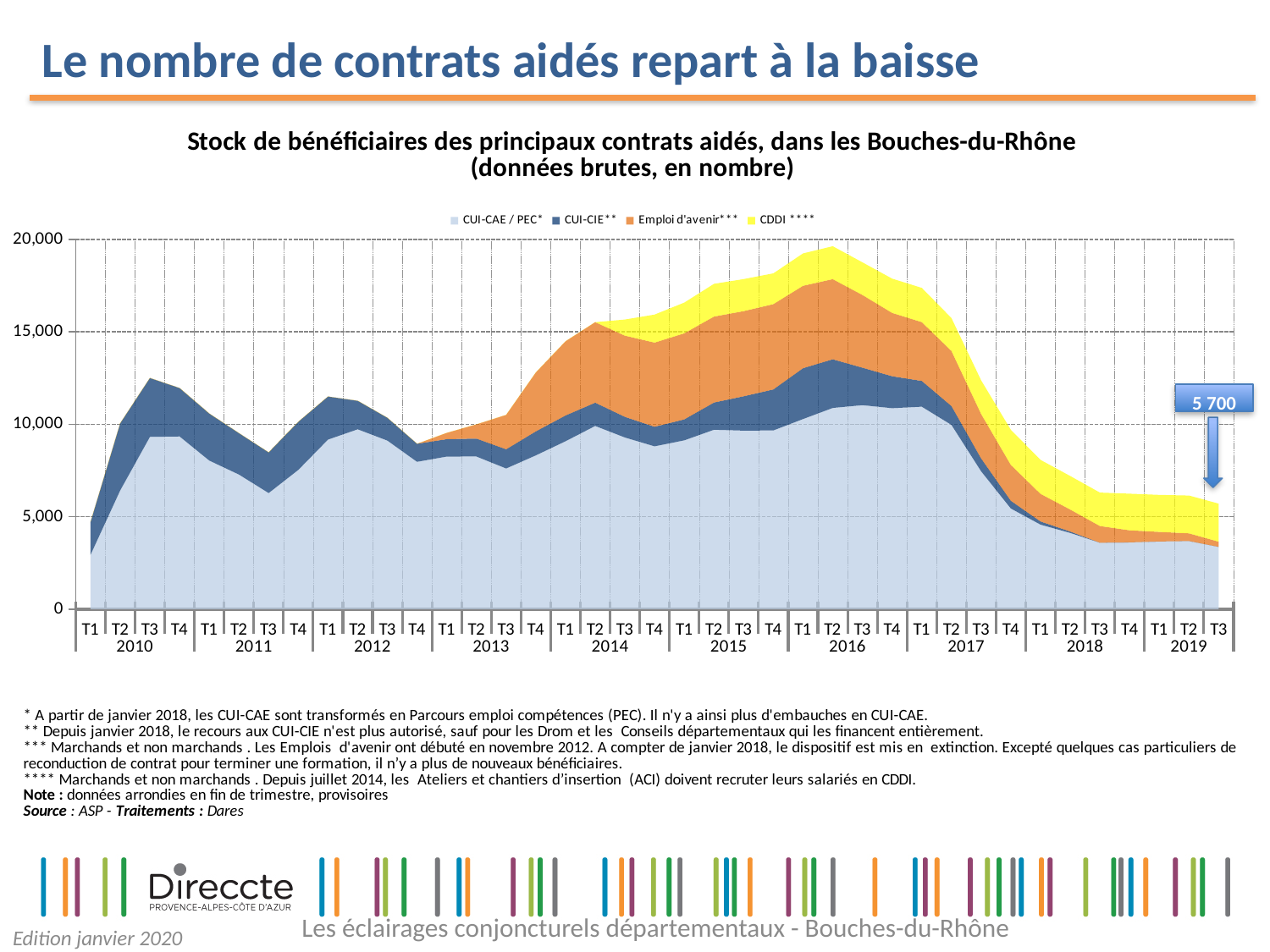
What kind of chart is shown on the slide? area chart Is the total stock of beneficiaries in T3 2010 greater or less than 10,000? greater Which is larger, the total stock in T2 2016 or in T3 2019? T2 2016 Is the total stock of beneficiaries in T3 2019 greater or less than 10,000? less How many series does the legend list? 4 Which series is shown in yellow? CDDI **** In which year does the total stock of beneficiaries reach its highest level? 2016 Is the total stock of beneficiaries in T2 2016 greater or less than 15,000? greater How many quarters are plotted on the x axis? 39 What is the first entry in the chart legend? CUI-CAE / PEC* Do the total values rise or fall from 2017 to 2019? fall What total value is annotated for T3 2019? 5 700